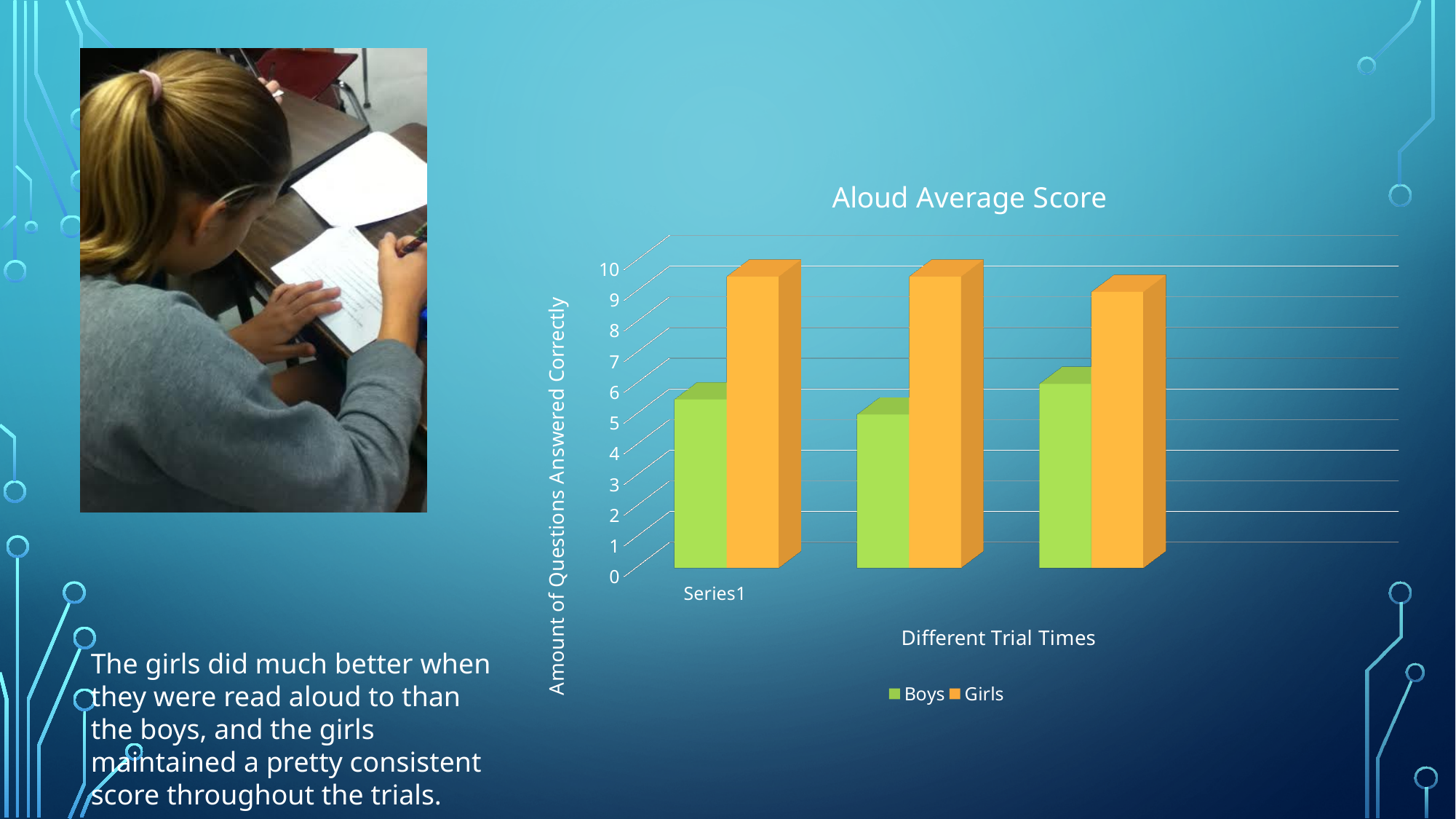
How many series does the chart's legend list? 2 How many groups of bars are plotted in the chart? 3 What is the title of the chart? Aloud Average Score In the Series1 group, which is larger, the Boys bar or the Girls bar? Girls What are the two series named in the chart's legend? Boys and Girls Is the Girls value for Series1 greater or less than 8? greater What is the label on the vertical axis of the chart? Amount of Questions Answered Correctly Is the Boys value for Series1 greater or less than 8? less Is the Boys value for Series1 greater or less than 3? greater Which series has the higher bars in every group of the chart? Girls What kind of chart is shown on the slide? bar chart